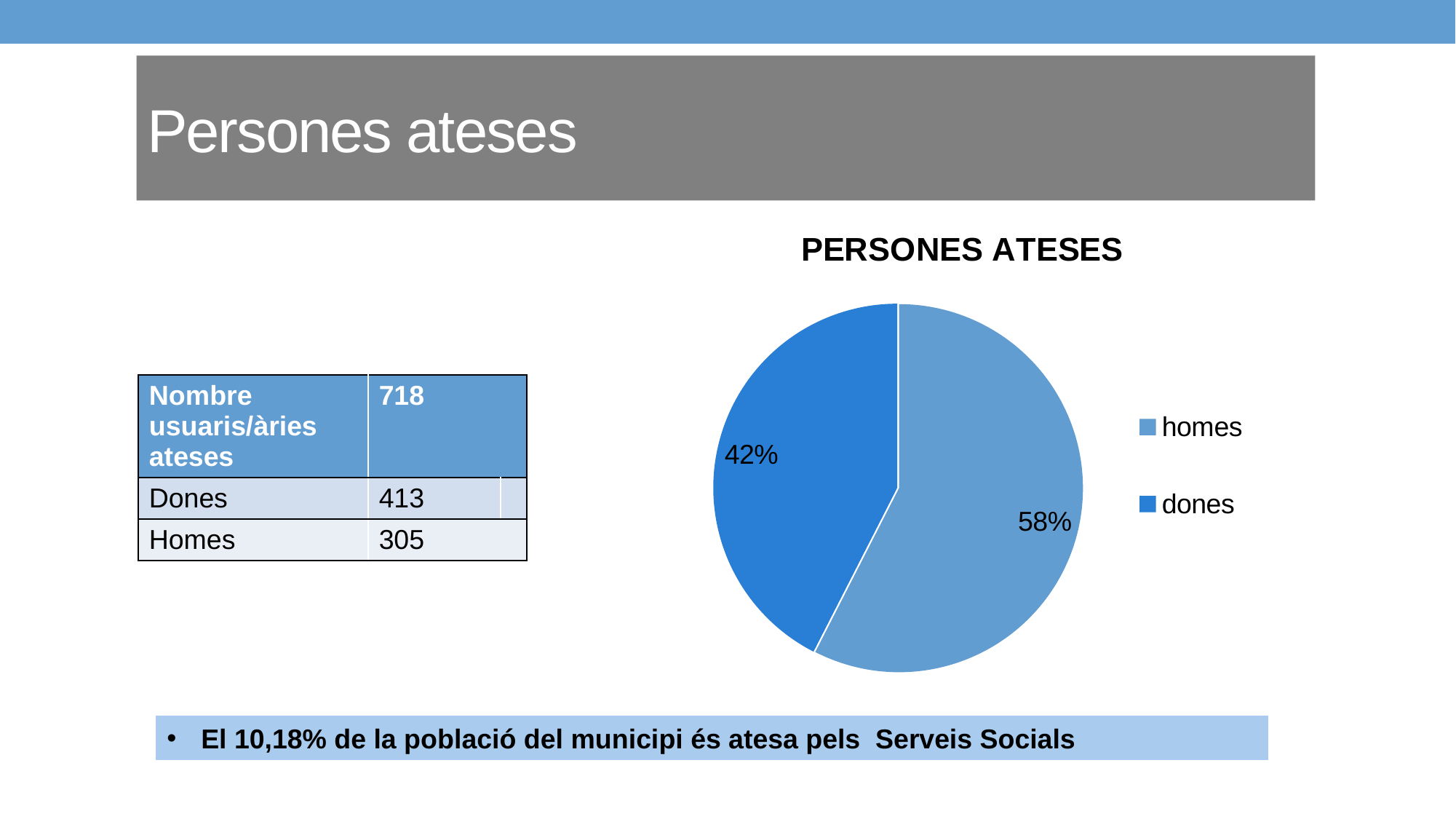
What percentage is shown for the slice labelled 'dones' in the pie chart? 42% What is the difference in percentage points between the two slices of the pie chart? 16 Which slice of the pie chart is the largest? homes Which legend entry is shown in the darker blue colour? dones What kind of chart is shown on the slide? pie chart How many entries does the chart legend list? 2 What is the title of the chart? PERSONES ATESES Which slice of the pie chart is the smallest? dones How many slices does the pie chart have? 2 What percentage is shown for the slice labelled 'homes' in the pie chart? 58% Is the share of the 'dones' slice greater or less than 50%? less